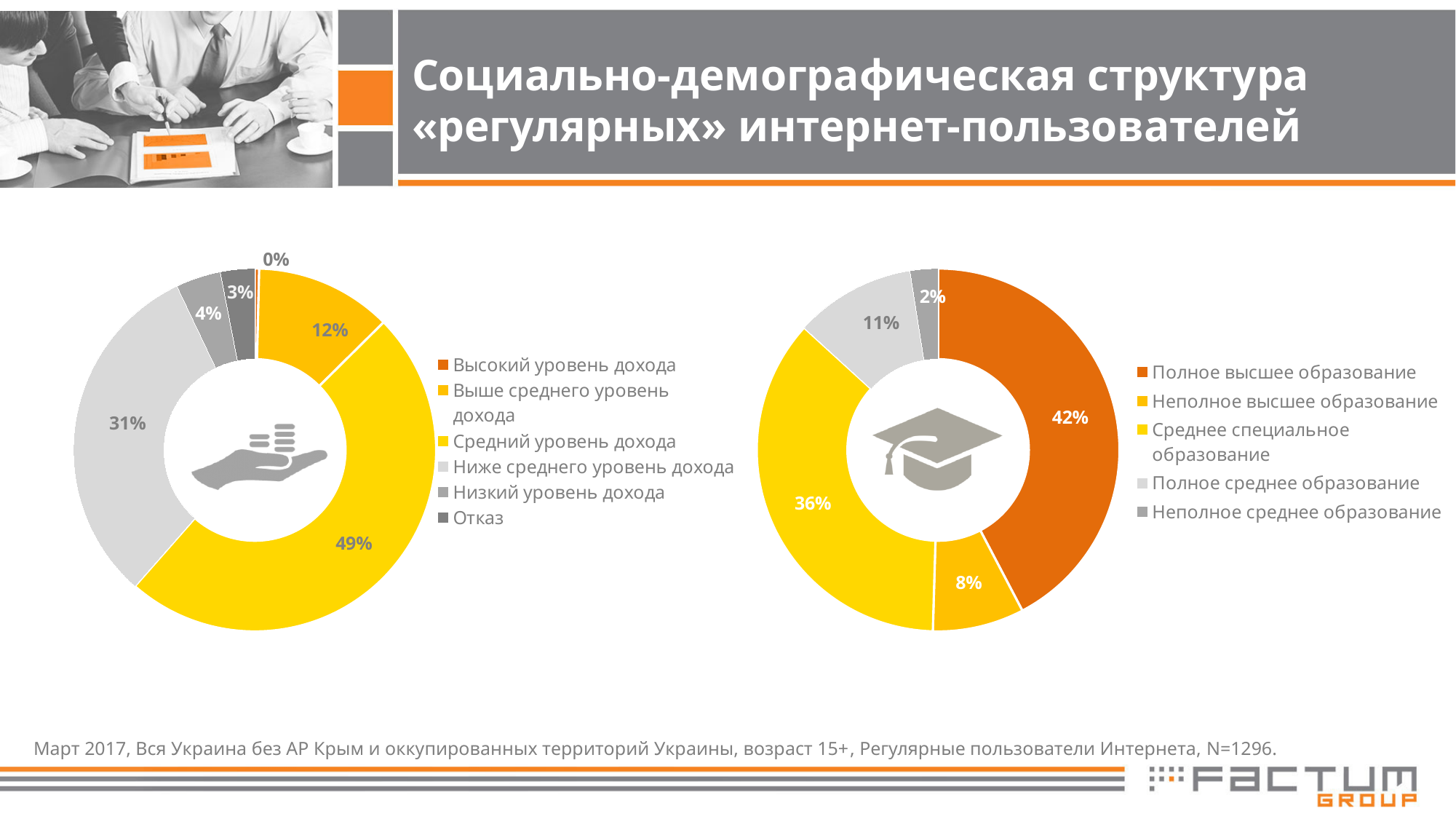
On the left chart, which income category has the largest share? Средний уровень дохода What type of chart is used on the right side of the slide? Doughnut (pie) chart On the right chart, which education category has the smallest share? Неполное среднее образование On the right chart, what share of regular internet users have full higher education (Полное высшее образование)? 42% On the left chart, what is the difference between the shares for 'Средний уровень дохода' and 'Ниже среднего уровень дохода'? 18% On the left chart, what is the value for 'Отказ'? 3% On the right chart, which is larger: 'Среднее специальное образование' or 'Полное среднее образование'? Среднее специальное образование On the left chart, which category has the smallest share? Высокий уровень дохода On the left chart, what percentage corresponds to 'Ниже среднего уровень дохода'? 31% How many categories does the legend of the left chart list? 6 On the right chart, what is the value for 'Неполное высшее образование'? 8% On the left chart, what share of regular internet users have a medium income level (Средний уровень дохода)? 49%